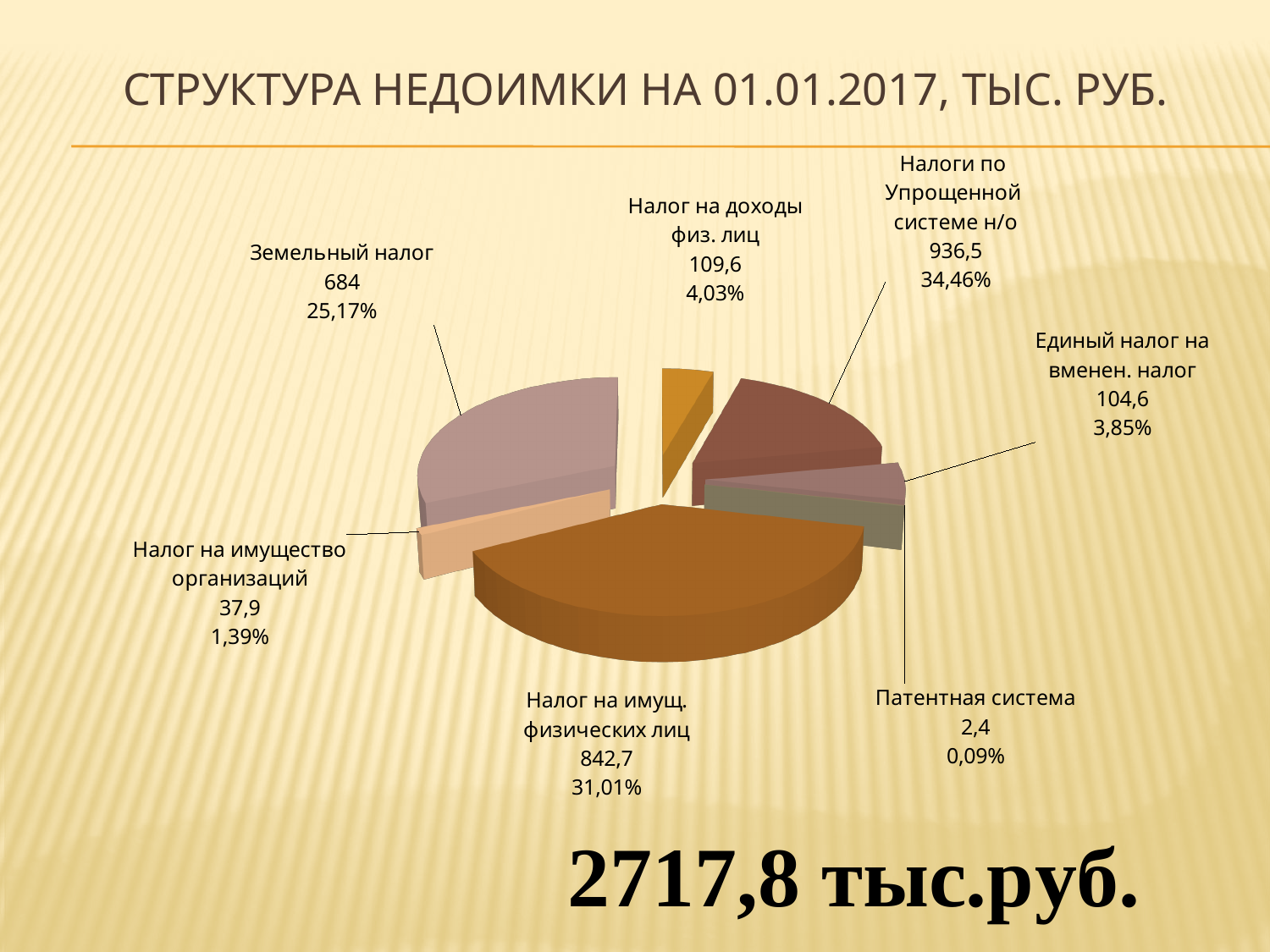
What share of the pie does Налог на доходы физ. лиц represent? 4,03% Which is larger: the value for Налог на доходы физ. лиц or for Единый налог на вменен. налог? Налог на доходы физ. лиц How many slices does the pie chart have? 7 Which category has the smallest value? Патентная система What is the value for Земельный налог? 684 What is the title of the chart? СТРУКТУРА НЕДОИМКИ НА 01.01.2017, ТЫС. РУБ. What share of the pie does Патентная система represent? 0,09% Which category has the largest value? Налоги по Упрощенной системе н/о What is the value for Налоги по Упрощенной системе н/о? 936,5 What is the difference between the values for Налоги по Упрощенной системе н/о and Налог на имущ. физических лиц? 93,8 What is the value for Налог на имущ. физических лиц? 842,7 What type of chart is shown on the slide? Pie chart